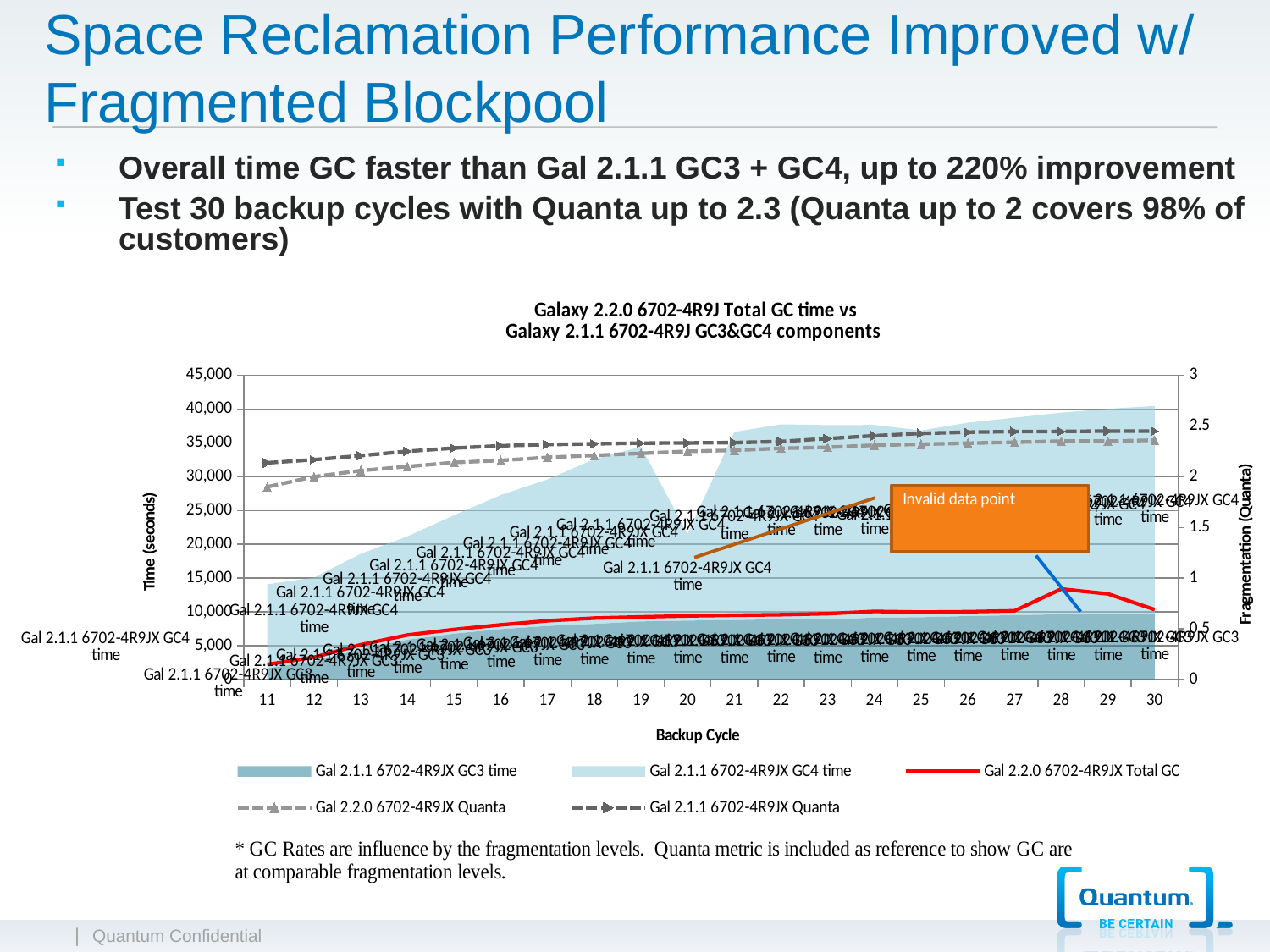
Is the Gal 2.1.1 6702-4R9JX Quanta value at backup cycle 30 greater or less than 2? greater Is the Gal 2.2.0 6702-4R9JX Total GC value at backup cycle 11 greater or less than 5,000 seconds? less How many series does the chart legend list? 5 Is the Gal 2.2.0 6702-4R9JX Total GC value at backup cycle 28 greater or less than 10,000 seconds? greater Does the Gal 2.1.1 6702-4R9JX Quanta line generally rise or fall from backup cycle 11 to backup cycle 30? rise At backup cycle 11, which Quanta series is higher: Gal 2.1.1 6702-4R9JX Quanta or Gal 2.2.0 6702-4R9JX Quanta? Gal 2.1.1 6702-4R9JX Quanta What is the label of the x axis of the chart? Backup Cycle At which backup cycle does the Gal 2.2.0 6702-4R9JX Total GC line reach its highest value? 28 How many backup cycles are shown along the x axis of the chart? 20 What is the title of the chart on the slide? Galaxy 2.2.0 6702-4R9J Total GC time vs Galaxy 2.1.1 6702-4R9J GC3&GC4 components At which backup cycle is the Gal 2.2.0 6702-4R9JX Total GC line at its lowest value? 11